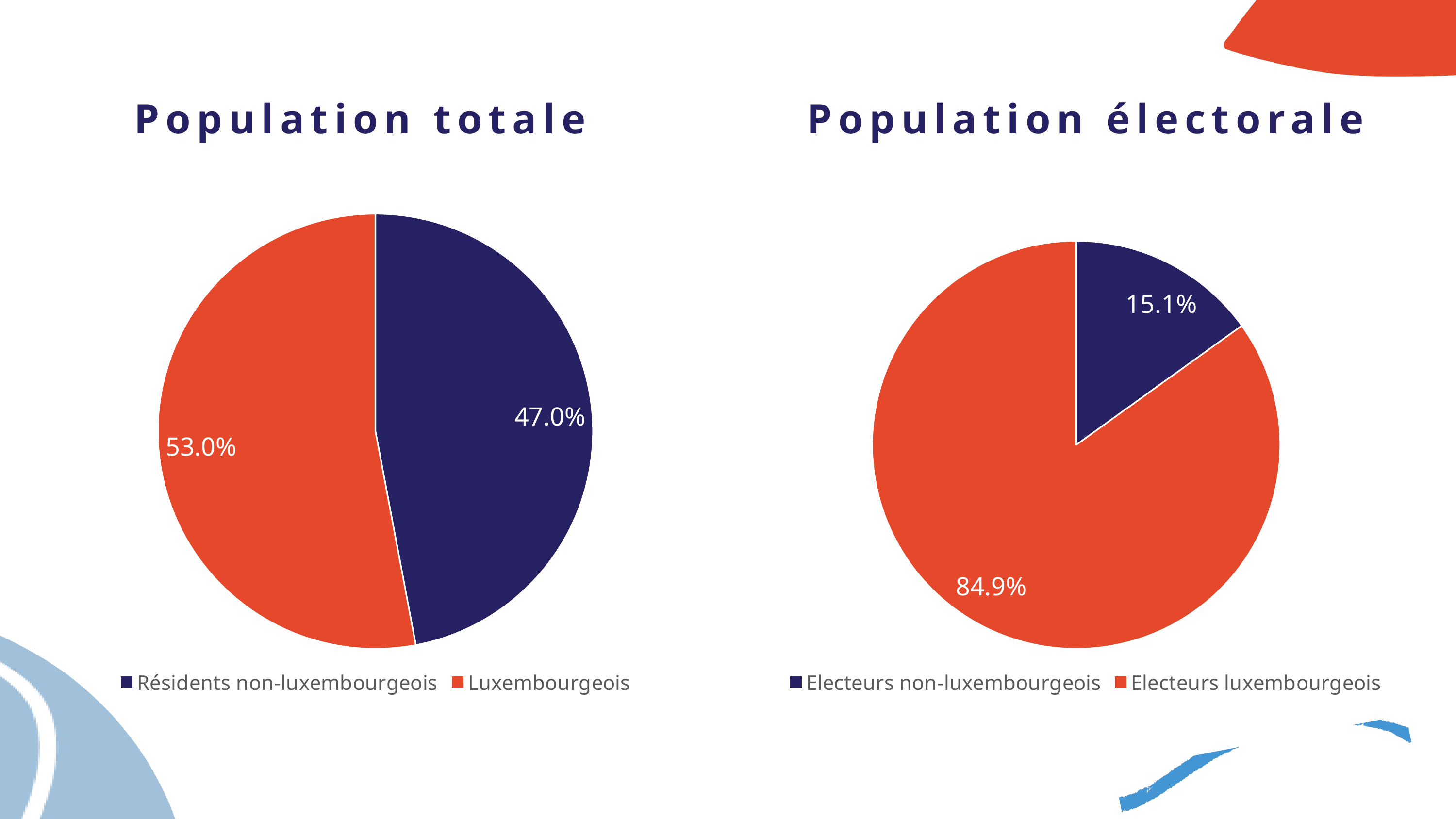
In the 'Population totale' chart, what is the difference between the Luxembourgeois and Résidents non-luxembourgeois shares? 6.0% In the 'Population électorale' chart, what colour is the Electeurs luxembourgeois slice? Orange-red How many slices does the 'Population totale' chart have? 2 In the 'Population électorale' chart, what share is labelled for Electeurs non-luxembourgeois? 15.1% In the 'Population électorale' chart, which slice is the smallest? Electeurs non-luxembourgeois In the 'Population totale' chart, what share is labelled for Résidents non-luxembourgeois? 47.0% In the 'Population totale' chart, what share is labelled for Luxembourgeois? 53.0% In the 'Population électorale' chart, what share is labelled for Electeurs luxembourgeois? 84.9% In the 'Population électorale' chart, what is the difference between the Electeurs luxembourgeois and Electeurs non-luxembourgeois shares? 69.8% In the 'Population totale' chart, which slice is the largest? Luxembourgeois What kind of chart is the 'Population électorale' chart? Pie chart Which is larger: the non-Luxembourgish share in the 'Population totale' chart or in the 'Population électorale' chart? Population totale